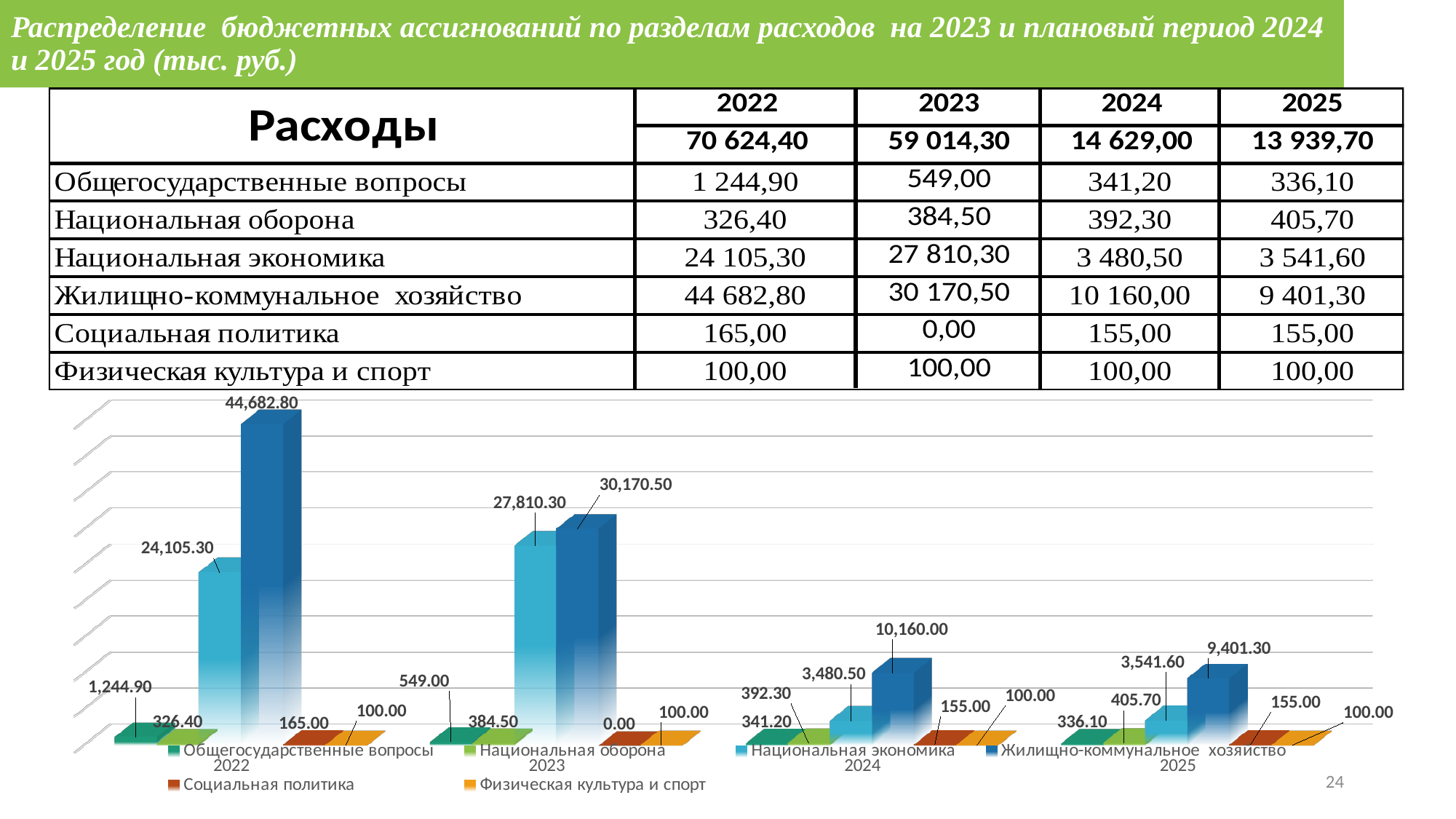
In the chart, which series has the lowest value in 2023? Социальная политика How many series does the chart legend list? 6 In the chart, does the value for Жилищно-коммунальное хозяйство rise or fall from 2022 to 2025? fall In the chart, what is the value for Национальная экономика in 2023? 27,810.30 In the chart, which year has the highest value for Жилищно-коммунальное хозяйство? 2022 In the chart, which is larger in 2023: Национальная экономика or Жилищно-коммунальное хозяйство? Жилищно-коммунальное хозяйство In the chart, what is the value for Жилищно-коммунальное хозяйство in 2022? 44,682.80 In the chart, what is the value for Социальная политика in 2023? 0.00 In the chart, what is the difference between the Жилищно-коммунальное хозяйство and Национальная экономика values in 2023? 2,360.20 What kind of chart is shown on the slide? bar chart In the chart, what is the difference between the Жилищно-коммунальное хозяйство values for 2024 and 2025? 758.70 How many year categories are shown on the x axis of the chart? 4